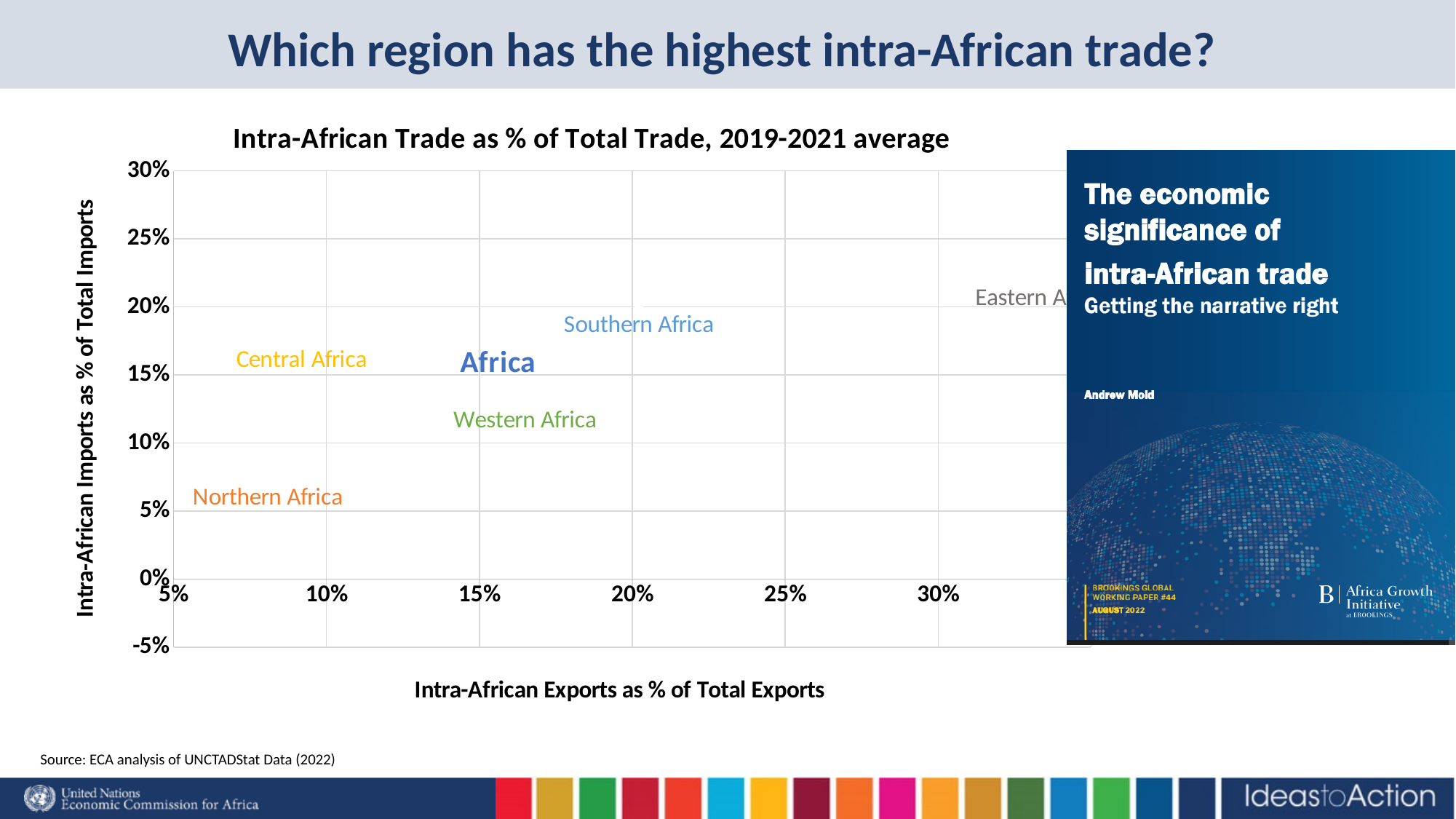
Is the intra-African exports value for Eastern Africa greater or less than 25%? greater What is the title of the chart? Intra-African Trade as % of Total Trade, 2019-2021 average Is the intra-African imports value for Southern Africa greater or less than 15%? greater Which region has the lowest intra-African imports as % of total imports? Northern Africa Which region has the lowest intra-African exports as % of total exports? Northern Africa Is the intra-African exports value for Central Africa greater or less than 15%? less Which has higher intra-African imports as % of total imports, Western Africa or Southern Africa? Southern Africa Which has higher intra-African exports as % of total exports, Northern Africa or Western Africa? Western Africa What is the label of the vertical axis of the chart? Intra-African Imports as % of Total Imports Which region has the highest intra-African exports as % of total exports? Eastern Africa What kind of chart is shown on the slide? scatter chart